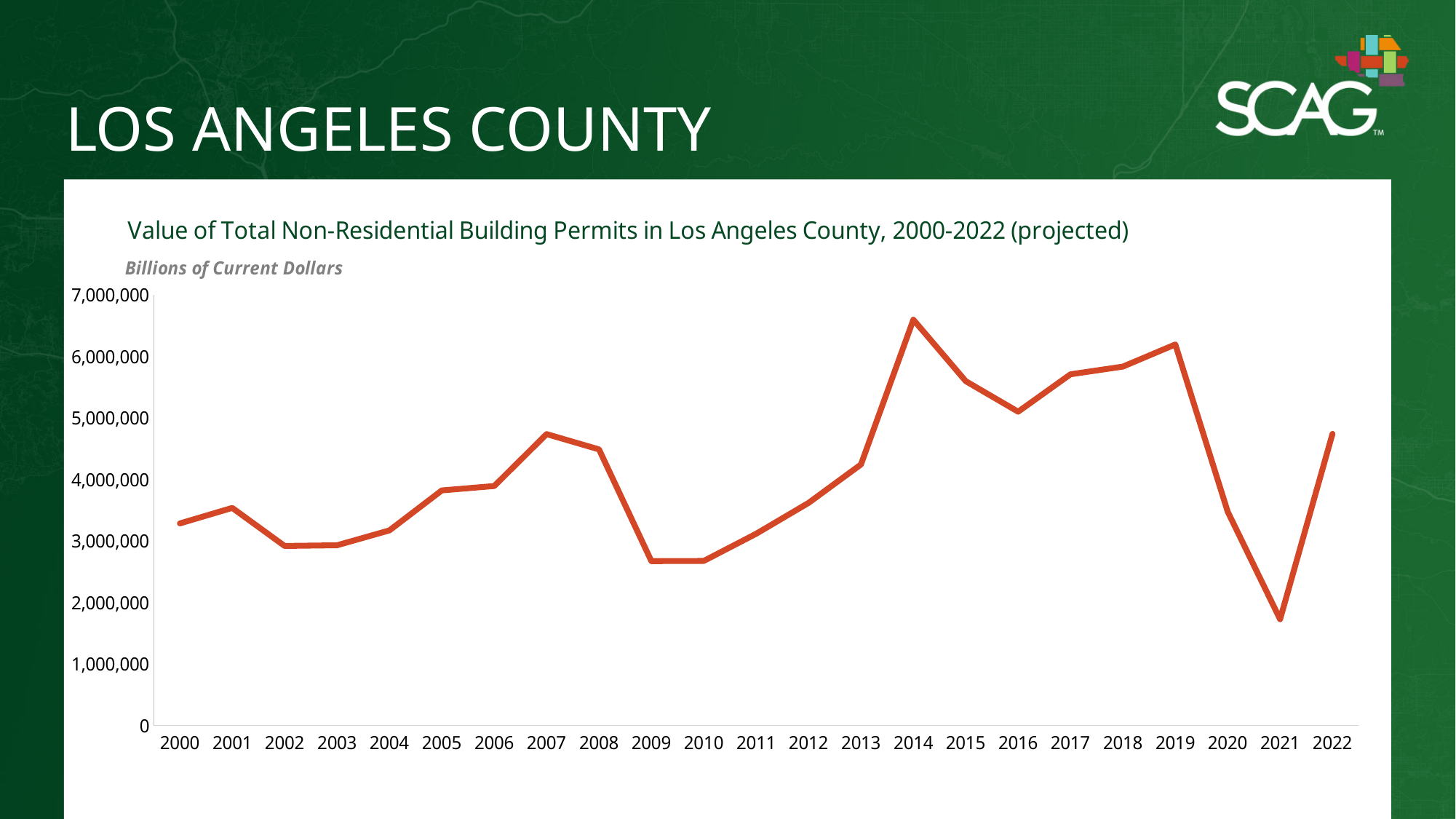
What unit is given for the y axis, as stated below the chart title? Billions of Current Dollars How many years are plotted on the x axis? 23 Is the value for 2021 greater or less than 2,000,000? less Is the value for 2020 greater or less than 4,000,000? less Which year has the highest value of non-residential building permits? 2014 Is the value for 2014 greater or less than 6,000,000? greater Do the values rise or fall from 2019 to 2021? fall Which year has the larger value, 2014 or 2019? 2014 What kind of chart is shown on the slide? line chart Which year has the lowest value of non-residential building permits? 2021